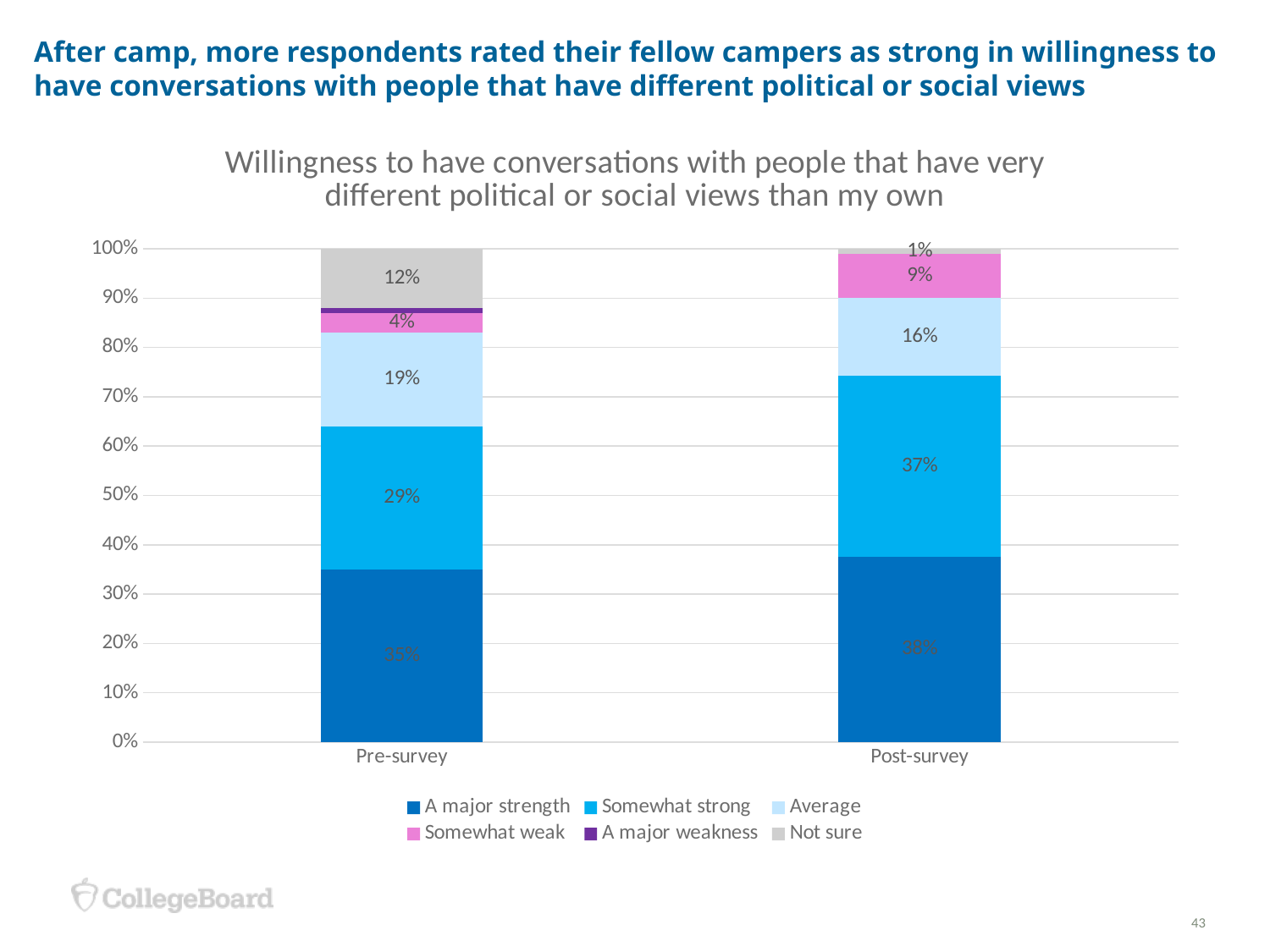
What percentage of the Pre-survey bar is 'Not sure'? 12% By how many percentage points did the 'Somewhat weak' share change from Pre-survey (4%) to Post-survey (9%)? 5 percentage points Which bar has the larger 'Average' share, Pre-survey or Post-survey? Pre-survey Is the 'A major strength' value for Post-survey greater or less than 30%? greater What is the 'Somewhat weak' value for Post-survey? 9% By how many percentage points did the 'Somewhat strong' share increase from Pre-survey to Post-survey? 8 percentage points What is the 'Somewhat weak' value for Pre-survey? 4% What kind of chart is shown on the slide? Stacked bar chart What percentage of Post-survey respondents rated willingness to have conversations as 'Somewhat strong'? 37% How many series does the legend list? 6 What is the 'Average' share in the Pre-survey bar? 19% How many bars (survey categories) are shown on the x axis? 2